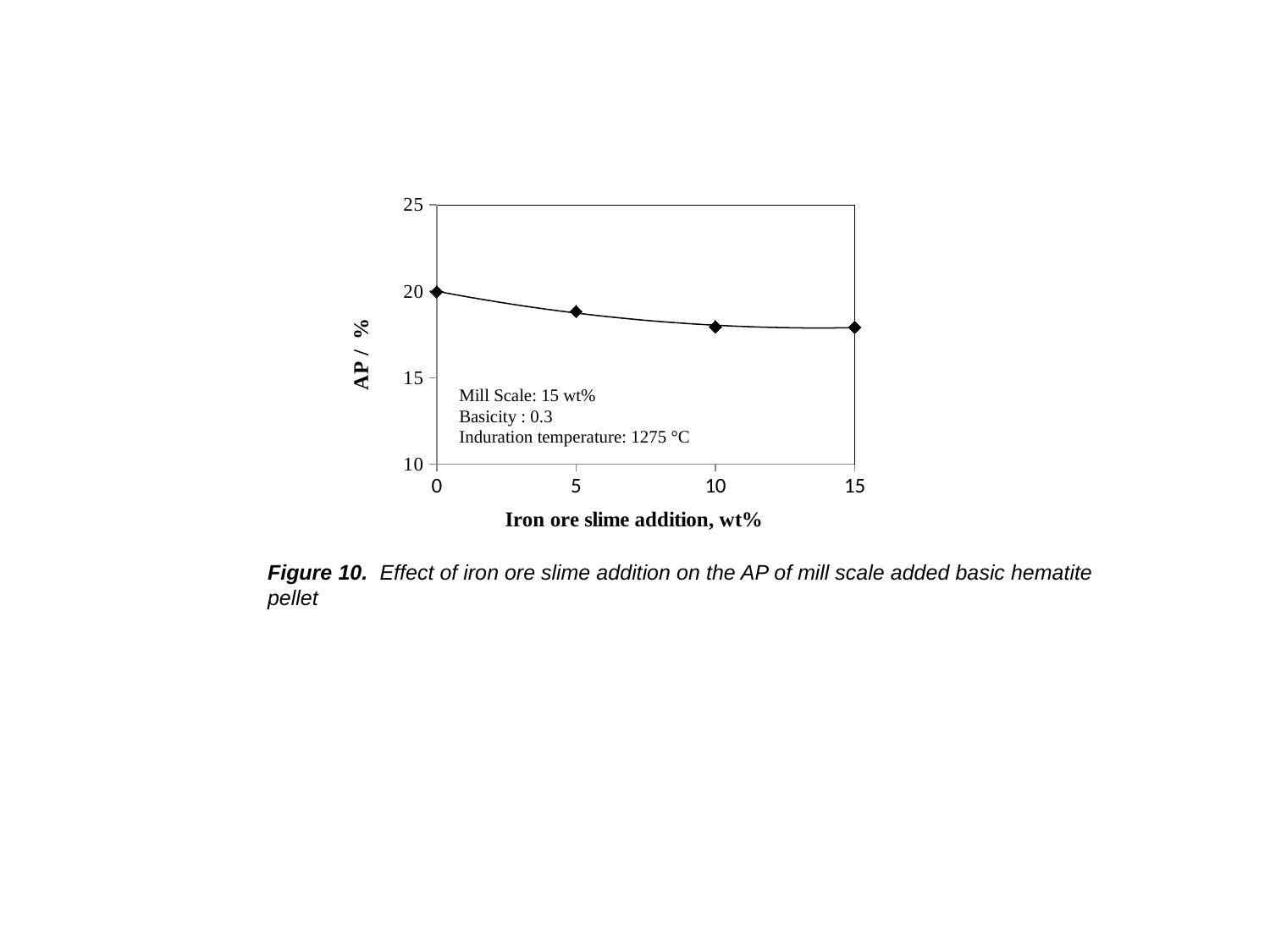
How many data points are plotted on the chart? 4 Is the AP value at 15 wt% iron ore slime addition greater or less than 20? less Which has a higher AP: 0 wt% or 15 wt% iron ore slime addition? 0 wt% Which has a higher AP: 5 wt% or 10 wt% iron ore slime addition? 5 wt% What is the label of the x axis? Iron ore slime addition, wt% What kind of chart is shown on the slide? line chart At which iron ore slime addition is the AP highest? 0 wt% What induration temperature is stated in the chart annotation? 1275 °C Does the AP rise or fall as iron ore slime addition increases? fall Is the AP value at 10 wt% iron ore slime addition greater or less than 15? greater Is the AP value at 5 wt% iron ore slime addition greater or less than 20? less